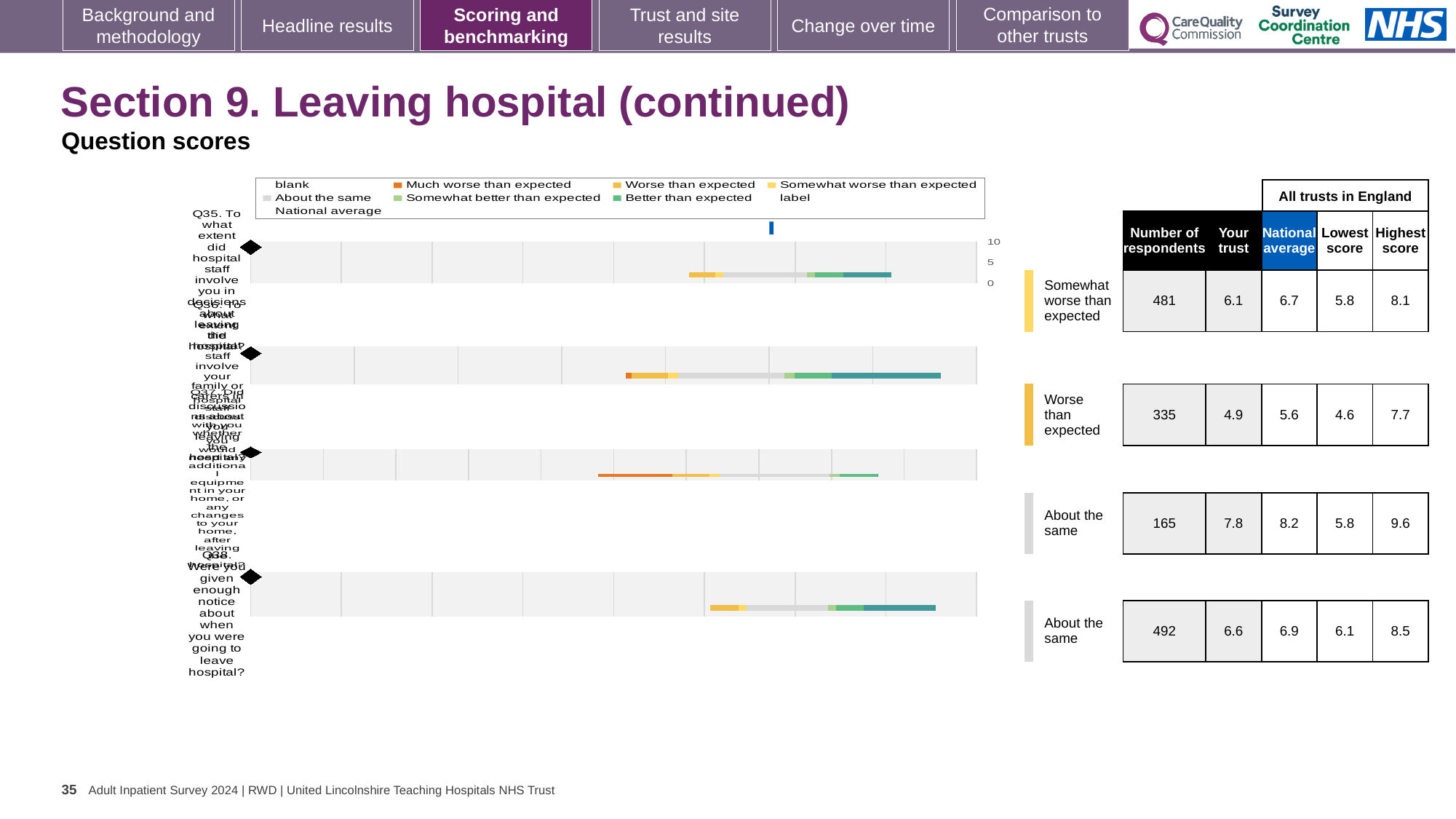
What kind of chart is used to show the question scores on this slide? bar chart In the table beside the chart, what is the difference between the national average and the 'Your trust' score for the second row ('Worse than expected')? 0.7 In the table beside the chart, how many respondents are listed for the row rated 'Worse than expected'? 335 How many question rows (bars) are plotted in the chart? 4 Which legend entry is shown in dark orange? Much worse than expected In the table beside the chart, what is the 'Your trust' score for Q35 (the first row, 'Somewhat worse than expected')? 6.1 In the table beside the chart, which row has the lowest 'Your trust' score? the second row (Worse than expected, 4.9) In the table beside the chart, is the highest score for the third row ('About the same') larger or smaller than the highest score for the first row? larger In the table beside the chart, what is the national average for Q38 (the last row, 'About the same')? 6.9 Which legend entry is shown in dark teal? Better than expected How many entries does the chart legend list? 9 In the table beside the chart, which row has the highest 'Your trust' score? the third row (About the same, 7.8)